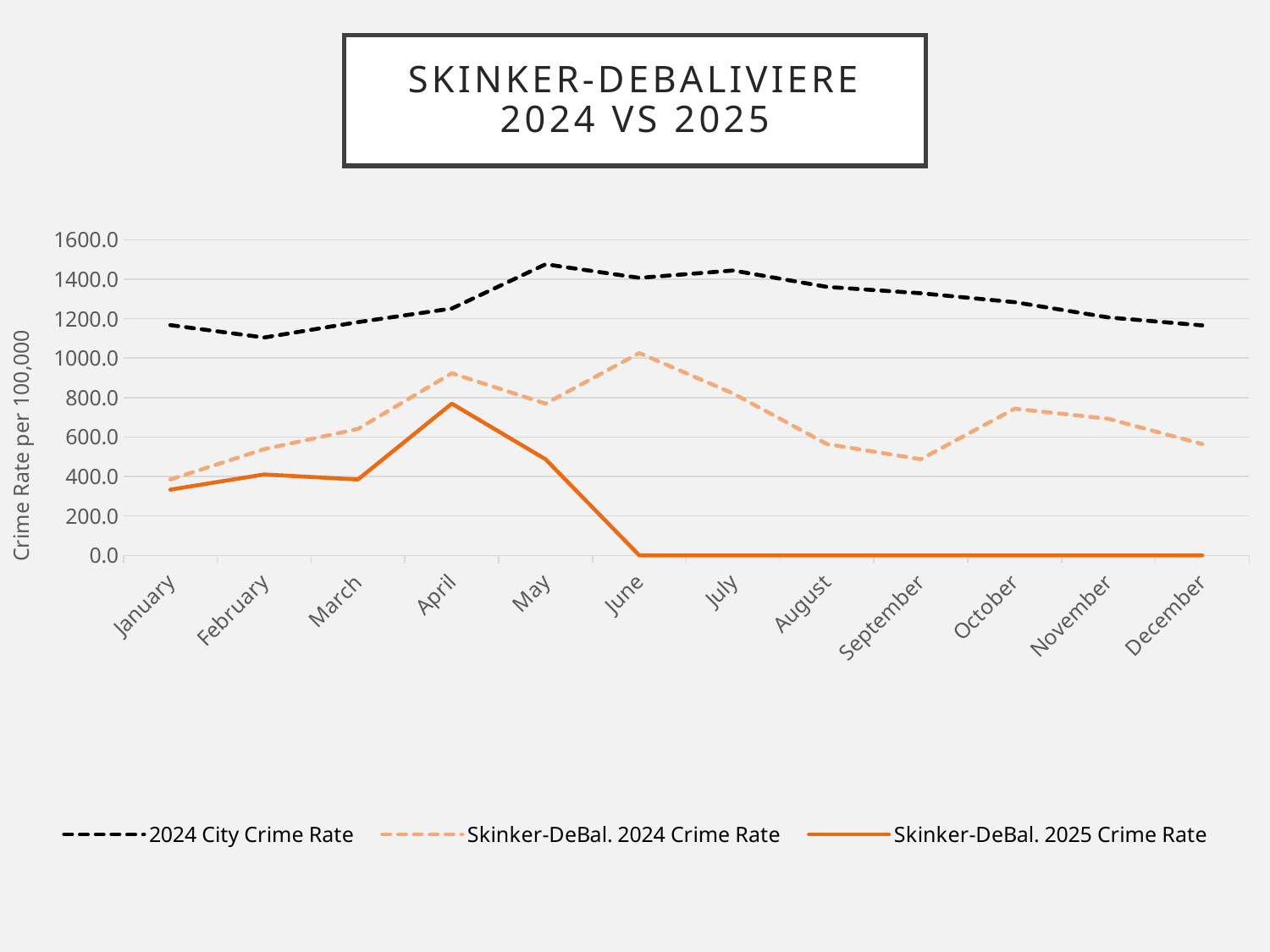
How many months are plotted along the x axis? 12 What is the Skinker-DeBal. 2025 Crime Rate value for December? 0.0 What is the Skinker-DeBal. 2025 Crime Rate value for June? 0.0 In which month is the Skinker-DeBal. 2024 Crime Rate highest? June Does the 2024 City Crime Rate rise or fall from July to December? Fall Is the Skinker-DeBal. 2024 Crime Rate for September greater or less than 600? less How many series does the legend list? 3 In which month is the Skinker-DeBal. 2025 Crime Rate highest? April In April, which is higher: the Skinker-DeBal. 2024 Crime Rate or the Skinker-DeBal. 2025 Crime Rate? Skinker-DeBal. 2024 Crime Rate What kind of chart is shown on the slide? Line chart Is the 2024 City Crime Rate for May greater or less than 1400? greater In which month is the Skinker-DeBal. 2024 Crime Rate lowest? January